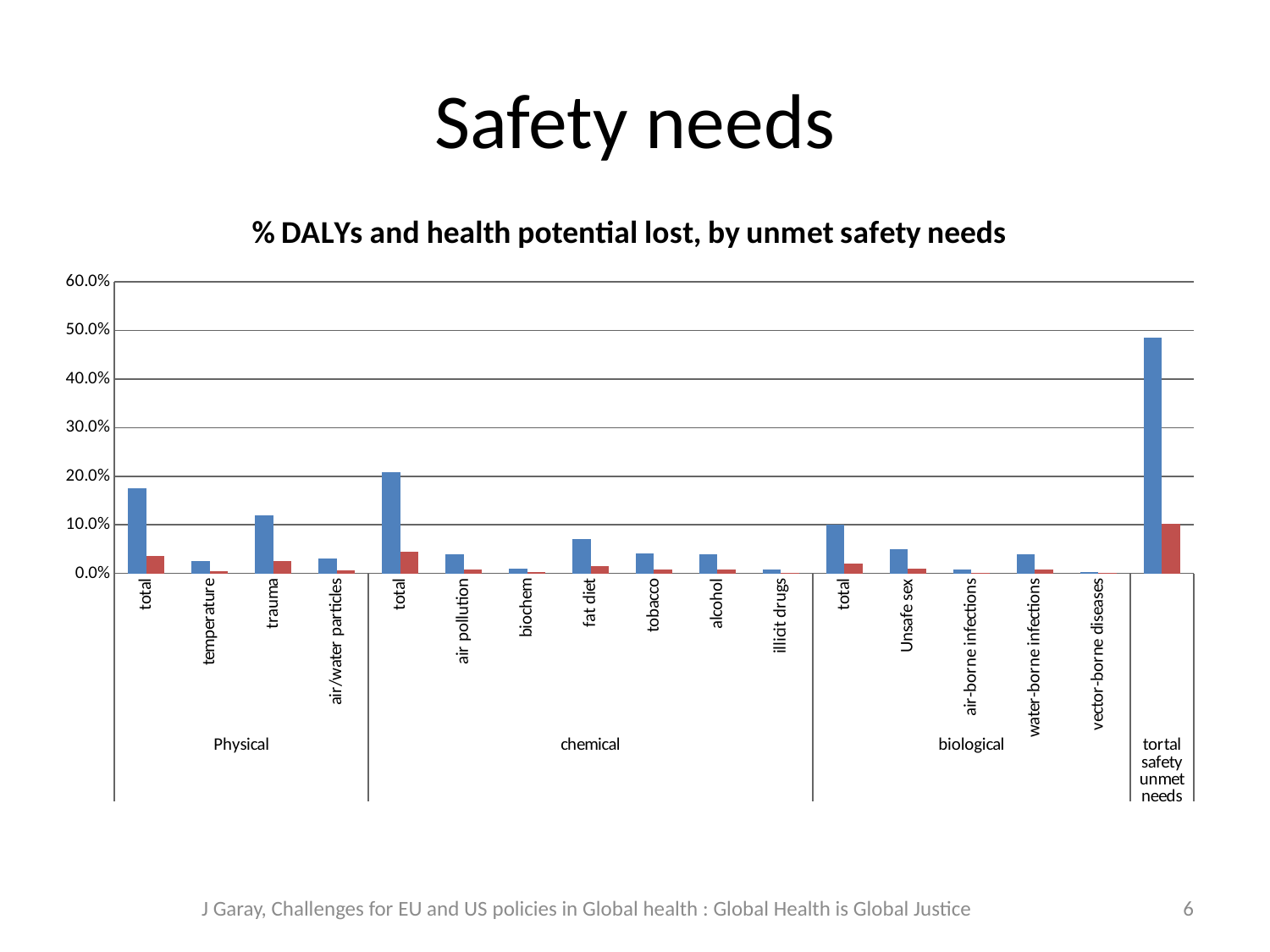
Which has the larger blue bar, the chemical total or the Physical total? chemical total Which category within the Physical group has the tallest blue bar? total Which category has the tallest blue bar in the chart? tortal safety unmet needs Is the blue bar for the Physical total greater or less than 20.0%? less Which has the larger blue bar, Unsafe sex or air-borne infections? Unsafe sex How many categories are shown along the x axis of the chart? 17 Is the blue bar for trauma greater or less than 10.0%? greater Is the blue bar for tortal safety unmet needs greater or less than 40.0%? greater What kind of chart is shown on the slide? bar chart What is the title of the chart? % DALYs and health potential lost, by unmet safety needs Which has the larger blue bar, trauma or temperature? trauma